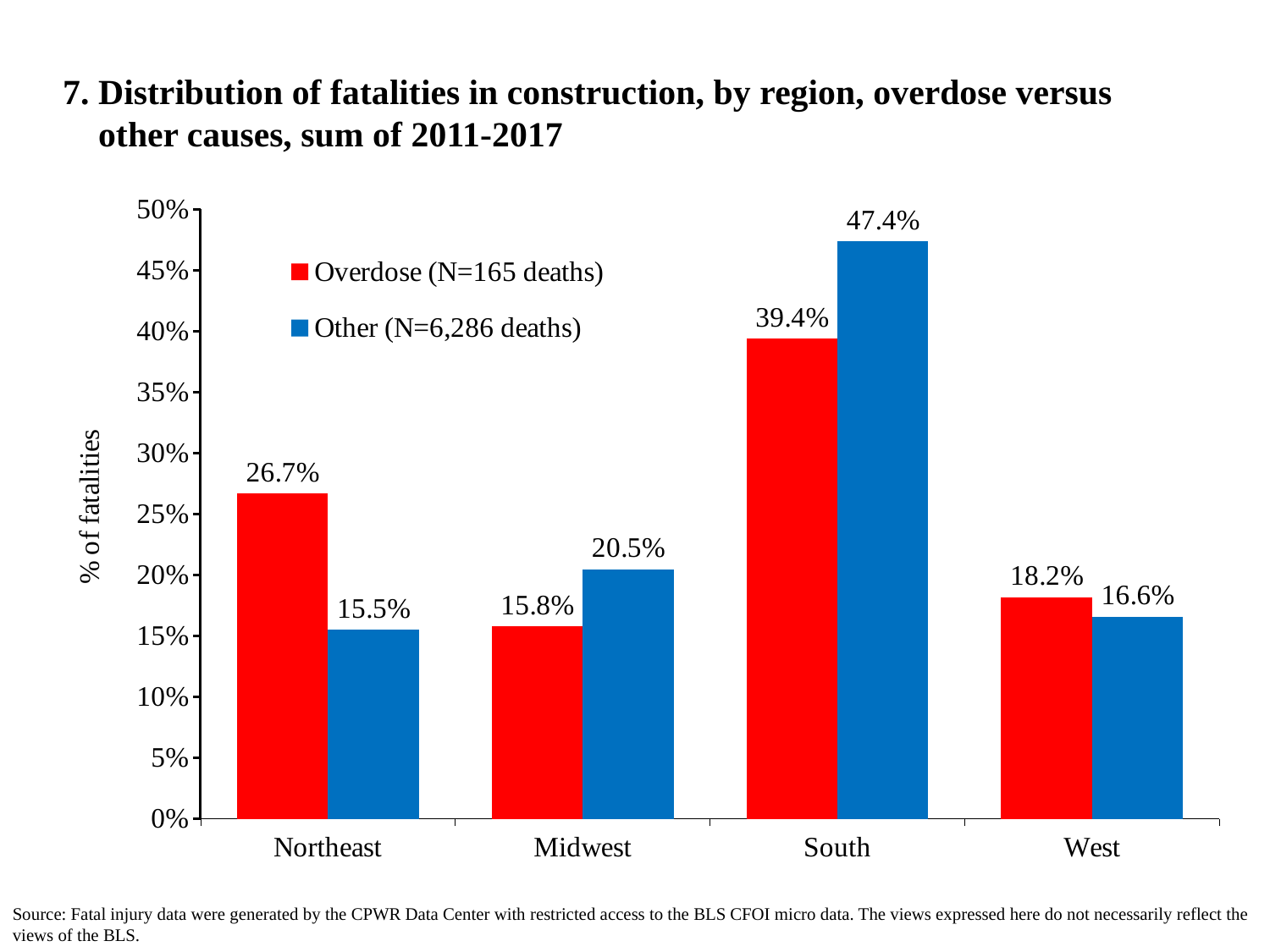
Which region has the lowest Overdose value? Midwest What is the Overdose value for the Northeast region? 26.7% Is the Overdose value for the South region greater or less than 35%? greater What is the Other value for the South region? 47.4% How many series does the legend list? 2 Which is larger for the Midwest region, the Overdose value or the Other value? Other What is the difference between the Other and Overdose values for the South region? 8.0% How many regions are shown on the x axis? 4 Which region has the highest Other value? South What colour are the Overdose bars? Red What is the Overdose value for the West region? 18.2% What kind of chart is shown on the slide? Bar chart